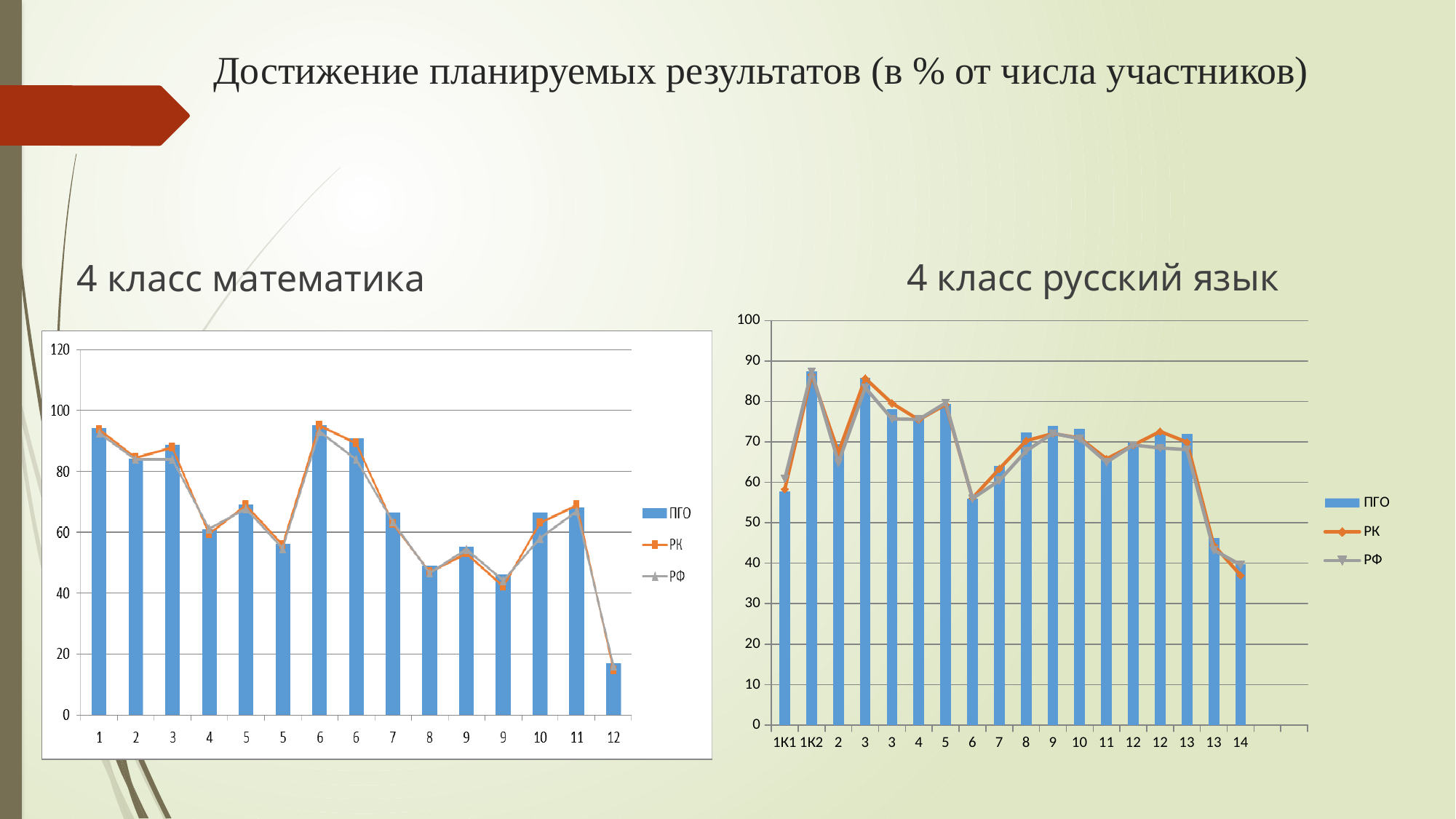
On the "4 класс математика" chart, which category has the lowest ПГО bar? 12 On the "4 класс русский язык" chart, which category has the lowest ПГО bar? 14 How many bars are plotted on the "4 класс русский язык" chart? 18 On the "4 класс русский язык" chart, is the ПГО value for category 1К1 larger or smaller than the value for 1К2? smaller On the "4 класс математика" chart, is the ПГО value for category 12 greater or less than 20? less What are the legend entries on the "4 класс математика" chart? ПГО, РК, РФ On the "4 класс русский язык" chart, is the ПГО value for category 14 greater or less than 50? less On the "4 класс русский язык" chart, which category has the highest ПГО bar? 1К2 How many series does the legend of the "4 класс русский язык" chart list? 3 How many bars are plotted on the "4 класс математика" chart? 15 On the "4 класс математика" chart, is the ПГО value for category 1 greater or less than 80? greater What kind of chart is the "4 класс математика" chart? bar chart with line series